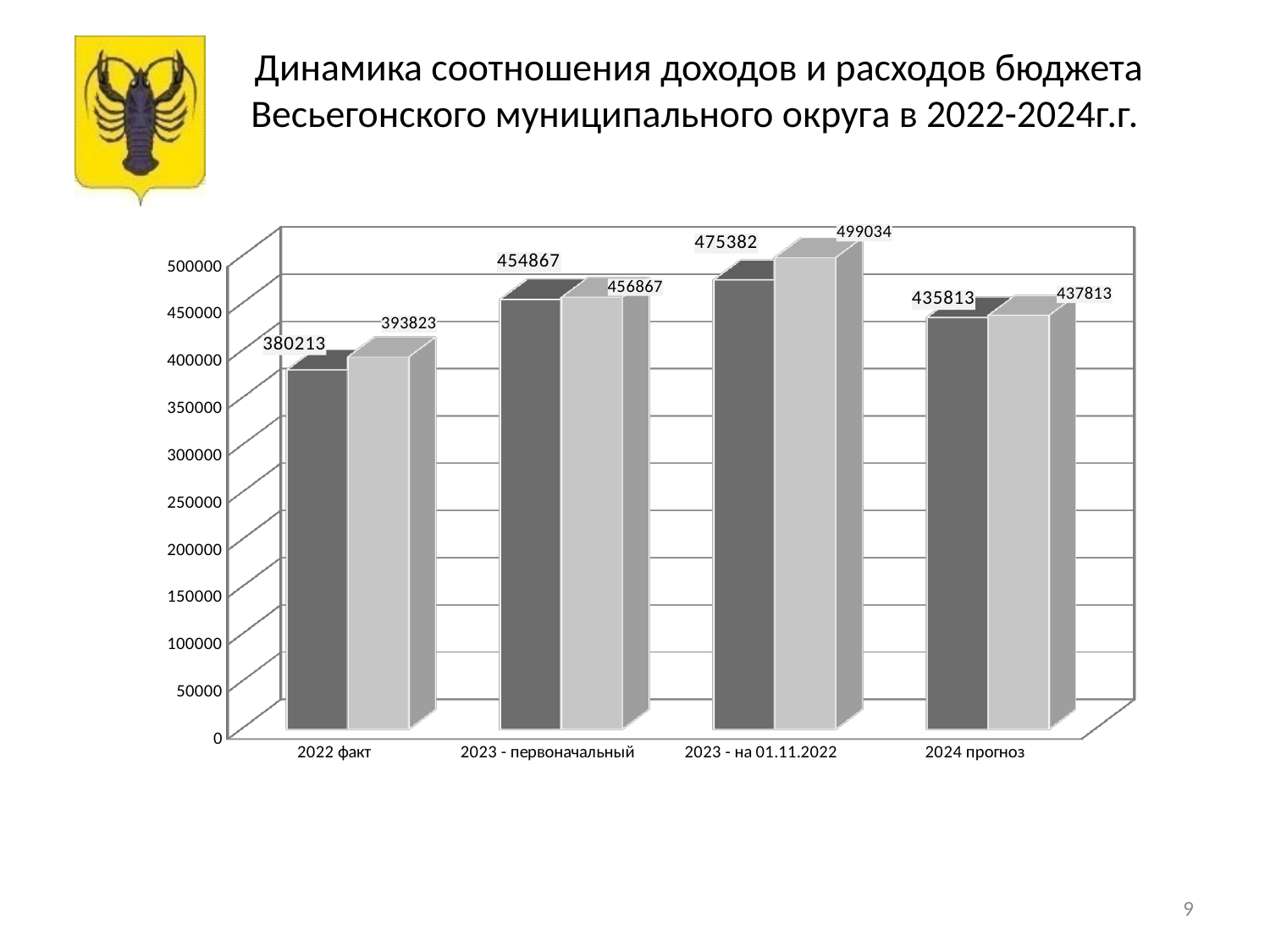
What is the title of the slide? Динамика соотношения доходов и расходов бюджета Весьегонского муниципального округа в 2022-2024г.г. What is the difference between the light grey and dark grey bars for 2022 факт? 13610 Which category has the lowest dark grey bar? 2022 факт What is the value of the dark grey bar for 2024 прогноз? 435813 What is the value of the dark grey bar for 2022 факт? 380213 What is the difference between the light grey and dark grey bars for 2023 - на 01.11.2022? 23652 What is the value of the light grey bar for 2023 - первоначальный? 456867 How many categories are shown on the x axis? 4 What is the value of the light grey bar for 2023 - на 01.11.2022? 499034 What kind of chart is shown on the slide? Bar chart Which category has the highest light grey bar? 2023 - на 01.11.2022 Which is larger: the dark grey bar for 2023 - первоначальный or the dark grey bar for 2024 прогноз? 2023 - первоначальный